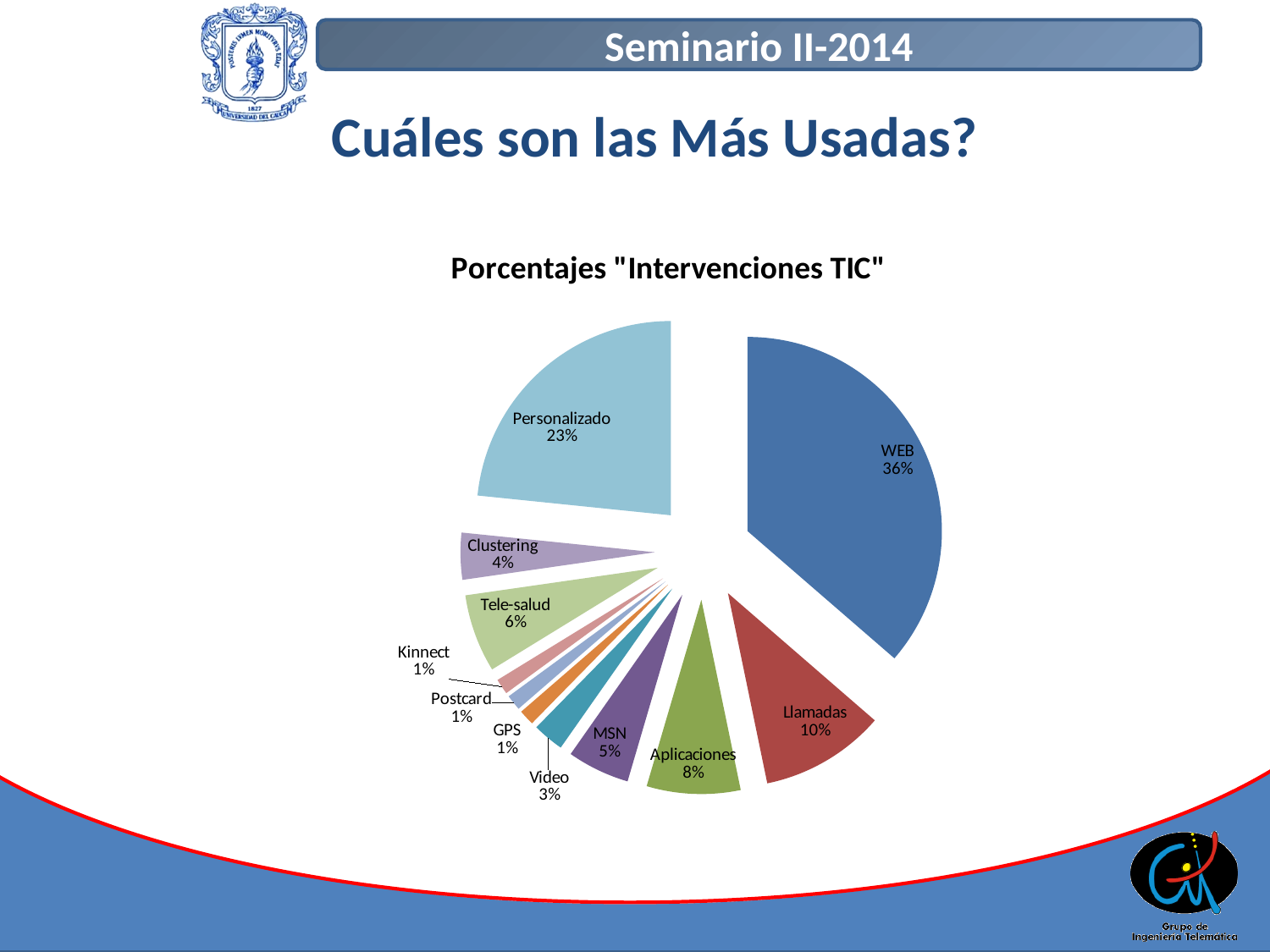
Which category has the largest share of the pie? WEB Which is larger, the share for Aplicaciones or the share for MSN? Aplicaciones What percentage does the Personalizado slice represent? 23% What percentage does the WEB slice represent? 36% What kind of chart is shown on the slide? pie chart How many slices does the pie chart have? 11 What percentage does the Llamadas slice represent? 10% What percentage does the Tele-salud slice represent? 6% What is the difference in percentage points between WEB and Personalizado? 13 What percentage does the Video slice represent? 3% What is the difference in percentage points between Llamadas and Clustering? 6 What is the title of the chart? Porcentajes "Intervenciones TIC"